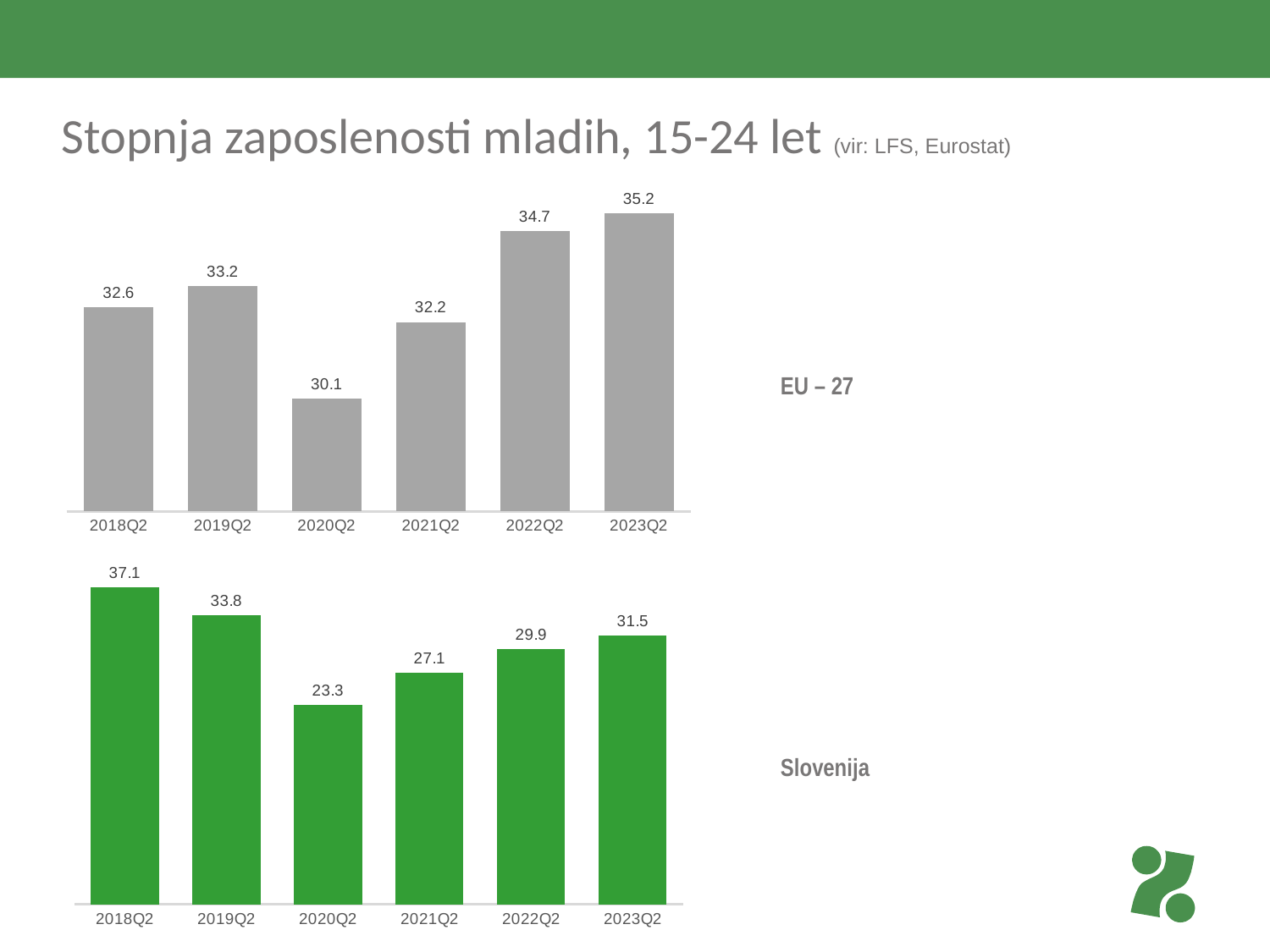
In the Slovenija chart (bottom), what is the difference between the 2018Q2 and 2020Q2 values? 13.8 In the Slovenija chart (bottom), do the values rise or fall from 2020Q2 to 2023Q2? Rise What kind of chart is the Slovenija chart (bottom)? Bar chart In the Slovenija chart (bottom), which is larger, the value for 2019Q2 or 2023Q2? 2019Q2 What colour are the bars in the EU – 27 chart (top)? Grey In the EU – 27 chart (top), which quarter has the highest value? 2023Q2 In the Slovenija chart (bottom), which quarter has the lowest value? 2020Q2 In the Slovenija chart (bottom), what is the value for 2023Q2? 31.5 In the Slovenija chart (bottom), which quarter has the highest value? 2018Q2 How many quarters are shown on the x axis of the EU – 27 chart (top)? 6 In the EU – 27 chart (top), what is the difference between the 2023Q2 and 2018Q2 values? 2.6 In the EU – 27 chart (top), what is the value for 2020Q2? 30.1